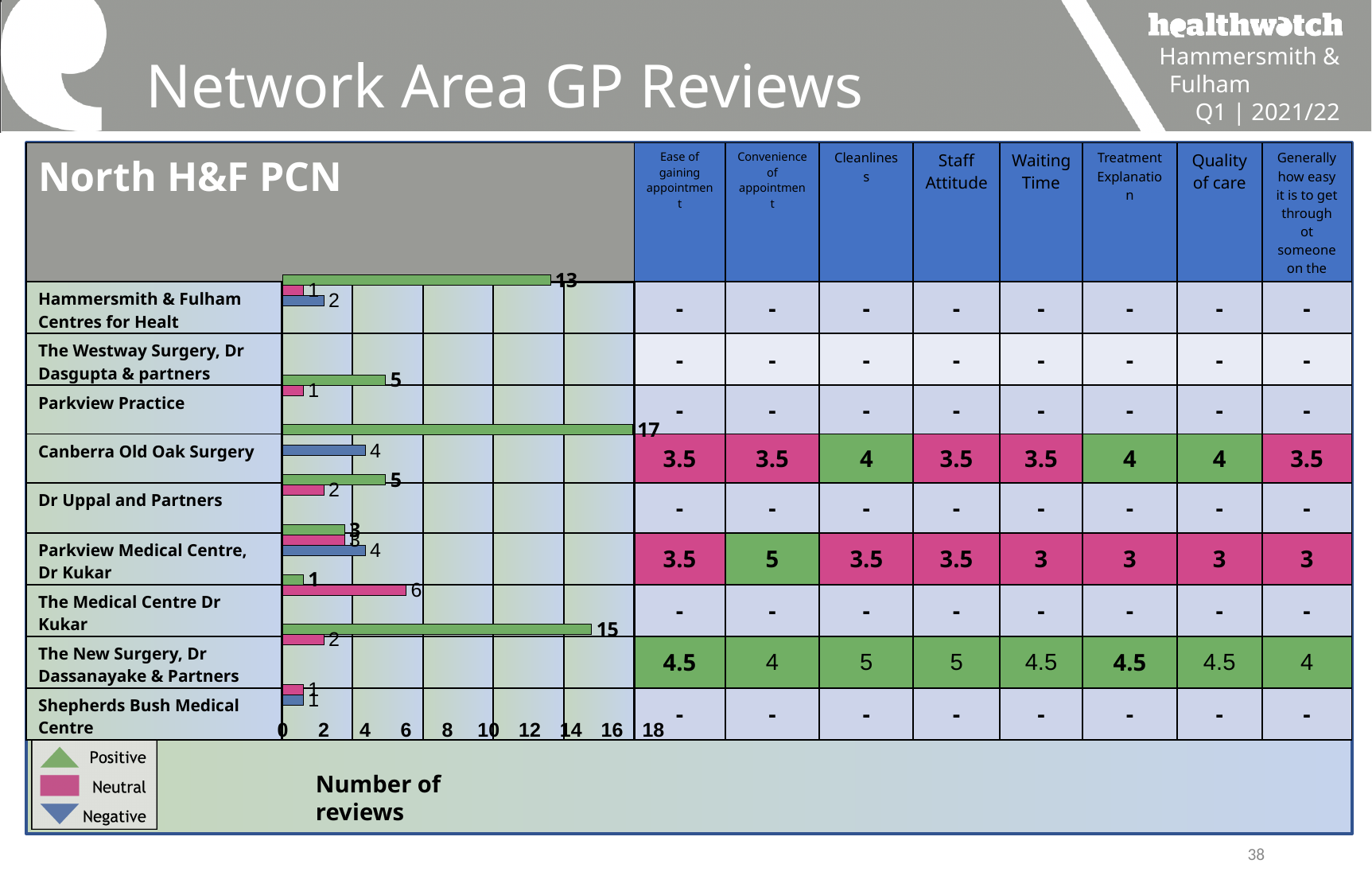
What is the value of the longest Negative (blue) bar on the chart? 4 What kind of chart is shown on the slide? bar chart What is the title of the chart's horizontal axis? Number of reviews Is the longest bar on the chart greater or less than 16? greater What is the value of the longest Positive (green) bar on the chart? 17 What is the smallest data label value shown on the chart? 1 What is the highest tick value shown on the chart's horizontal axis? 18 What is the value of the longest Neutral (pink) bar on the chart? 6 Which series has the longest bar on the chart? Positive How many series does the chart's legend list? 3 What are the three series named in the chart's legend? Positive, Neutral, Negative What is the difference between the longest Positive bar (17) and the longest Neutral bar (6)? 11